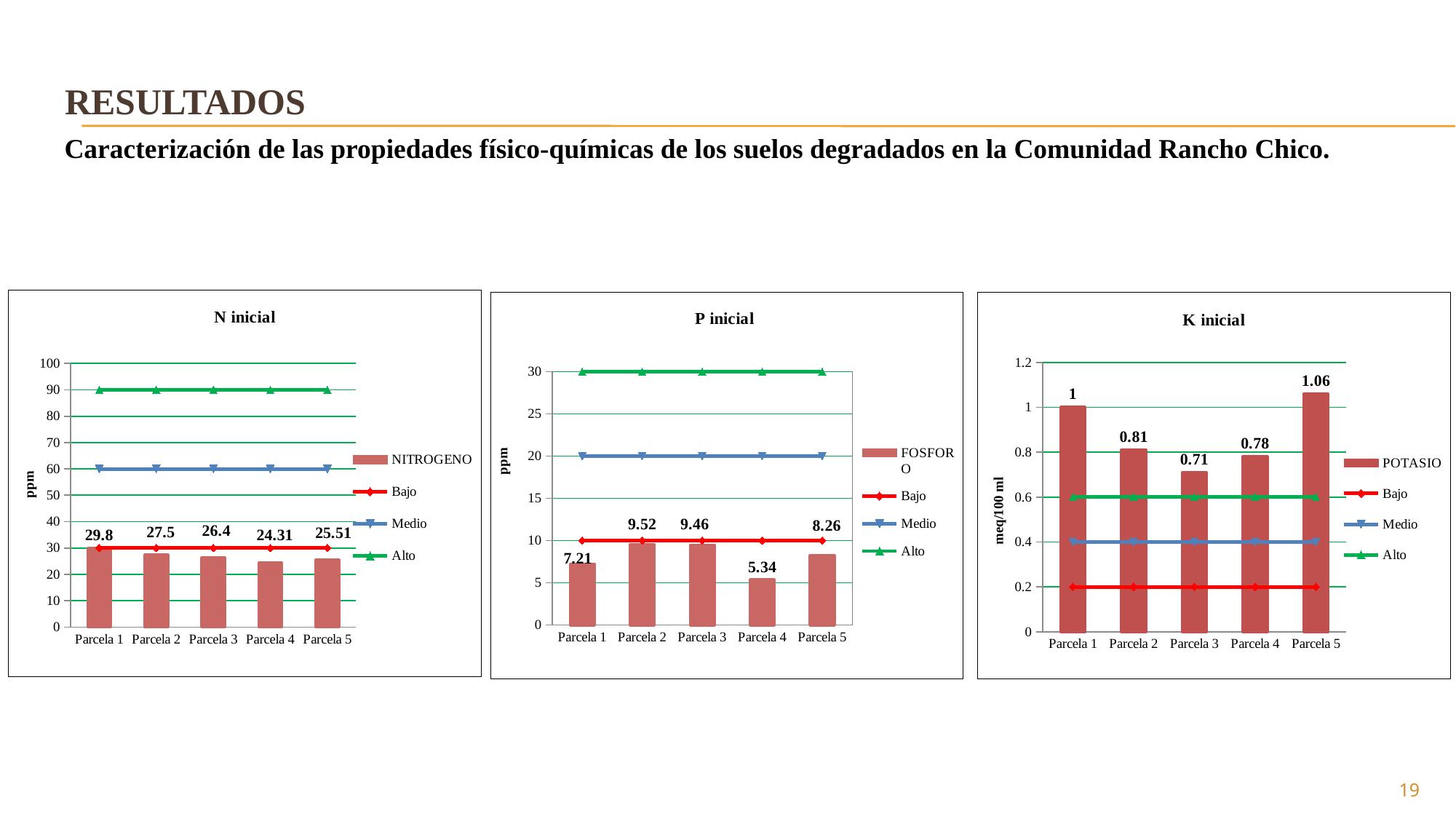
How many parcelas are shown on the x axis of the 'K inicial' chart? 5 In the 'P inicial' chart, is the FOSFORO value for Parcela 1 larger or smaller than the value for Parcela 5? smaller In the 'P inicial' chart, what is the FOSFORO value for Parcela 4? 5.34 In the 'K inicial' chart, which parcela has the highest POTASIO value? Parcela 5 How many series does the legend of the 'P inicial' chart list? 4 In the 'N inicial' chart, what is the NITROGENO value for Parcela 1? 29.8 In the 'N inicial' chart, which parcela has the lowest NITROGENO value? Parcela 4 What is the y-axis label of the 'K inicial' chart? meq/100 ml In the 'P inicial' chart, which parcela has the highest FOSFORO value? Parcela 2 In the 'N inicial' chart, what is the difference between the NITROGENO values for Parcela 1 and Parcela 4? 5.49 In the 'K inicial' chart, what is the POTASIO value for Parcela 3? 0.71 In the 'K inicial' chart, what is the difference between the POTASIO values for Parcela 5 and Parcela 3? 0.35